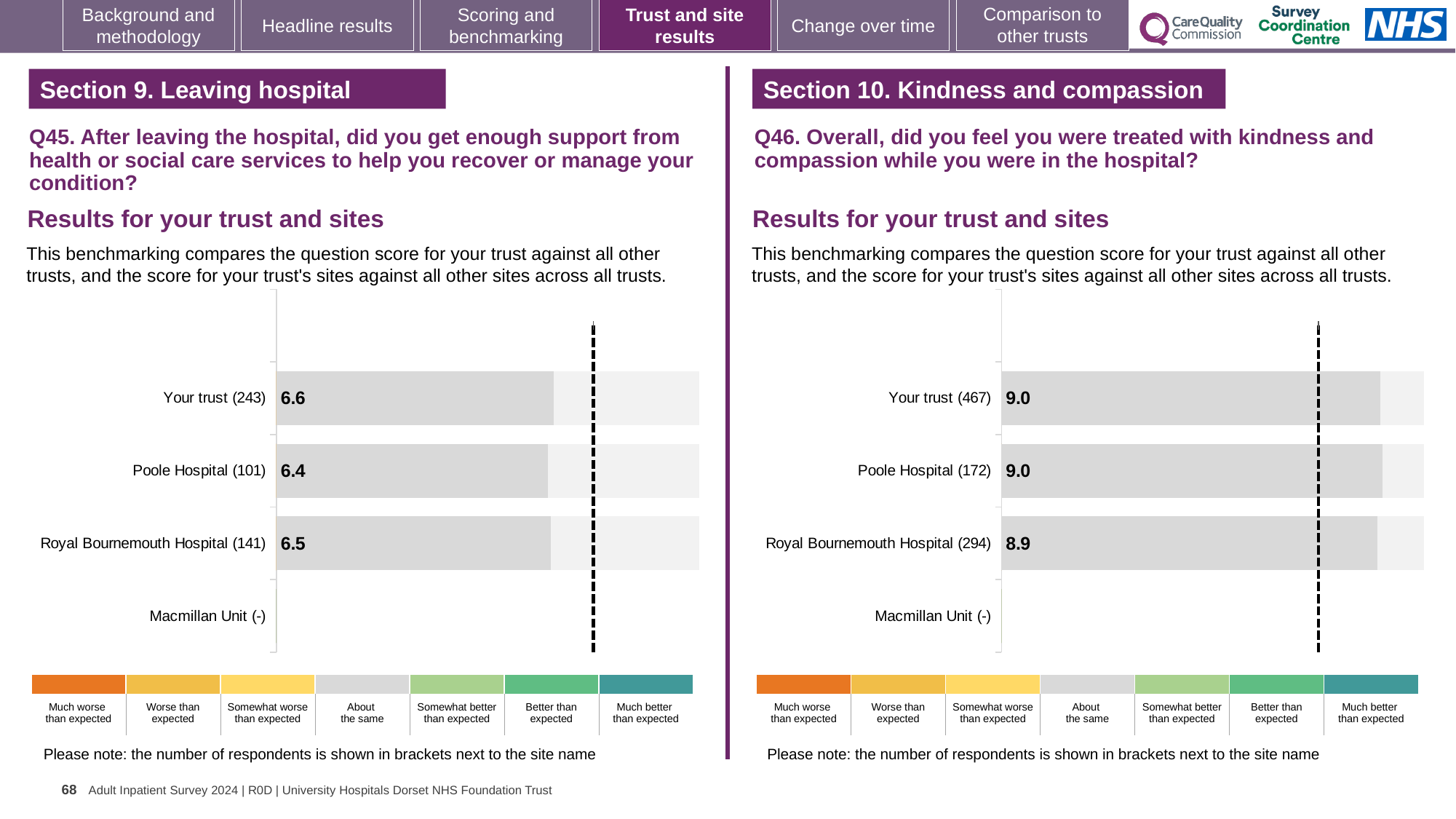
On the Q45 chart (left), which site or trust row has the lowest score? Poole Hospital On the Q46 chart (right), what is the score for Royal Bournemouth Hospital? 8.9 On the Q45 chart (left), what is the difference between the scores for Your trust and Poole Hospital? 0.2 On the Q45 chart (left), which is larger: the score for Royal Bournemouth Hospital or the score for Poole Hospital? Royal Bournemouth Hospital On the Q46 chart (right), what is the difference between the scores for Poole Hospital and Royal Bournemouth Hospital? 0.1 On the Q45 chart (left), which row has no score shown? Macmillan Unit On the Q45 chart (left), what is the score for Poole Hospital? 6.4 On the Q46 chart (right), what is the score for Your trust? 9.0 What kind of chart is used on the Q46 chart (right)? Bar chart On the Q45 chart (left), how many rows (sites or trust) are listed on the vertical axis? 4 On the Q46 chart (right), how many respondents are shown in brackets for Your trust? 467 On the Q45 chart (left), what is the score for Your trust? 6.6